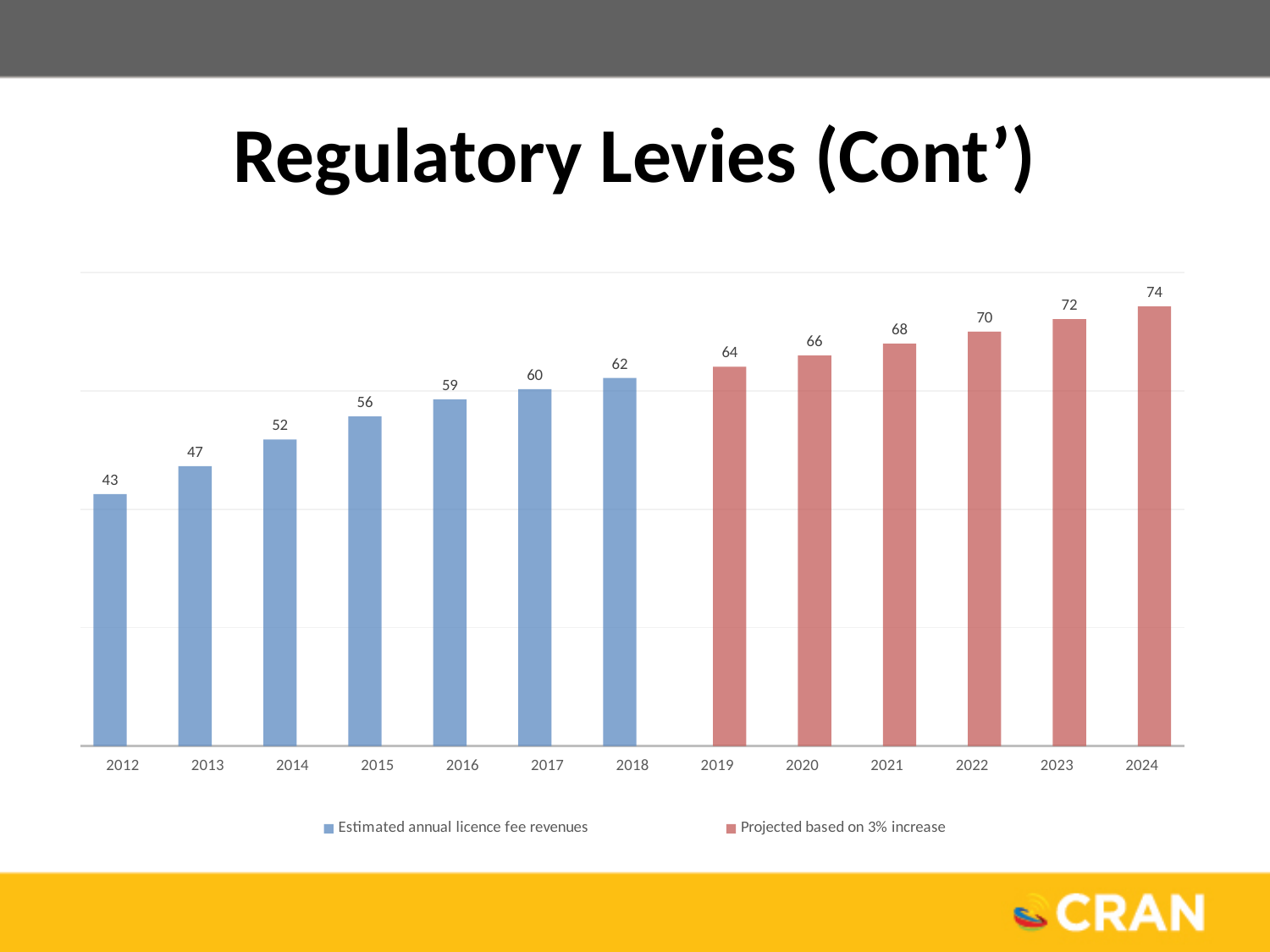
What is the difference between the values for 2024 and 2019? 10 Which year has the lowest value? 2012 How many years are shown on the x axis? 13 How many series does the legend list? 2 What is the difference between the values for 2018 and 2012? 19 What is the value for 2018? 62 What is the value for 2024? 74 What kind of chart is this? Bar chart Which year has the highest value? 2024 Which is larger, the value for 2015 or the value for 2020? 2020 Do the values rise or fall from 2012 to 2024? Rise What is the value for 2012? 43